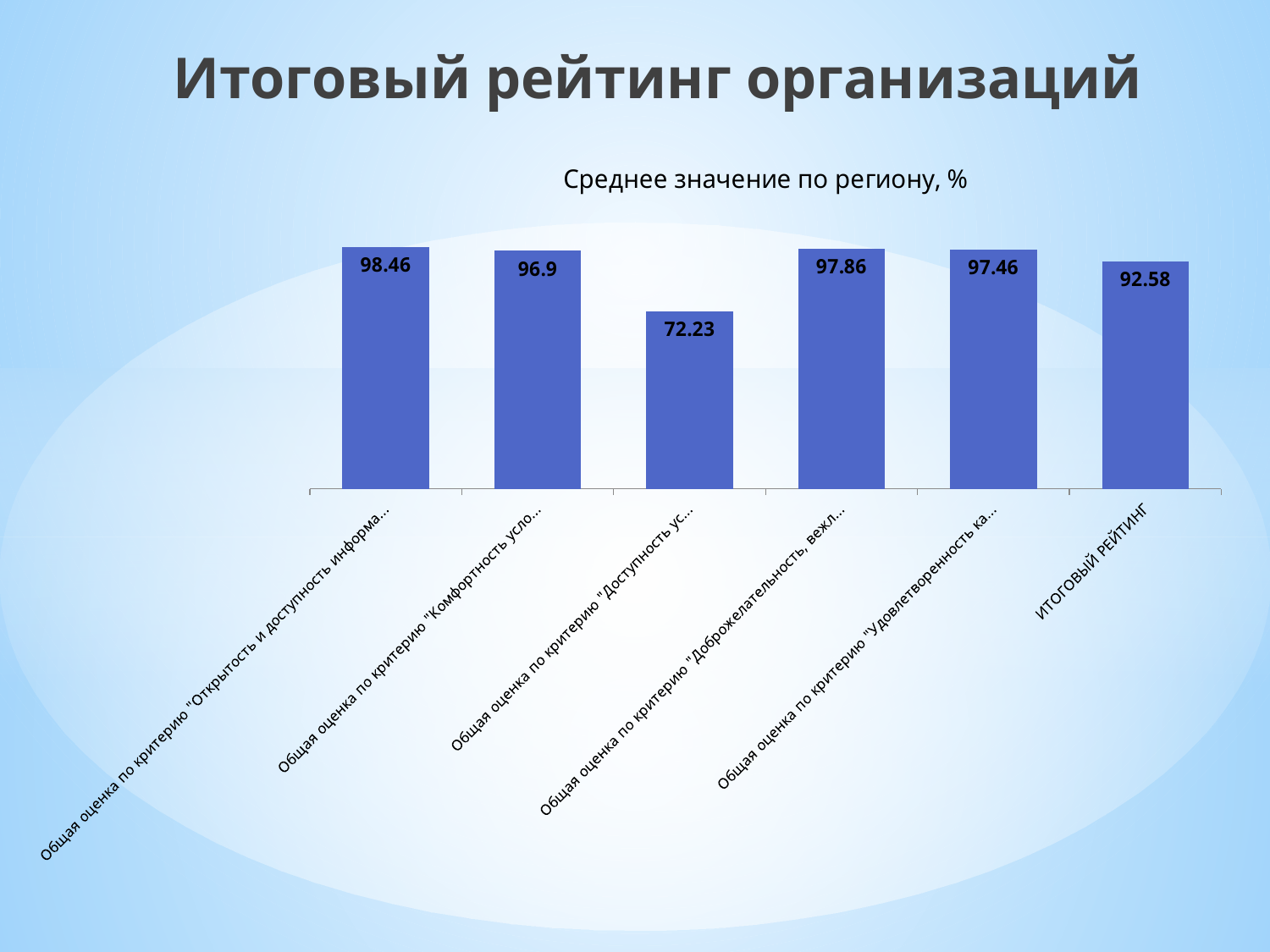
How many bars are shown in the chart? 6 What is the difference between the value for "Открытость и доступность информа..." (98.46) and the value for "Доступность ус..." (72.23)? 26.23 Which category has the highest value in the chart? Общая оценка по критерию "Открытость и доступность информа..." Which is larger: the value for "Комфортность усло..." or the value for "ИТОГОВЫЙ РЕЙТИНГ"? Комфортность усло... What type of chart is shown on the slide? Bar chart What is the value of the bar for the criterion "Доступность ус..."? 72.23 Which category has the lowest value in the chart? Общая оценка по критерию "Доступность ус..." What is the title of the chart? Среднее значение по региону, % What is the value of the bar for the criterion "Доброжелательность, вежл..."? 97.86 What is the value of the first bar, for the criterion "Открытость и доступность информа..."? 98.46 What is the value of the bar labelled "ИТОГОВЫЙ РЕЙТИНГ"? 92.58 What is the value of the bar for the criterion "Удовлетворенность ка..."? 97.46